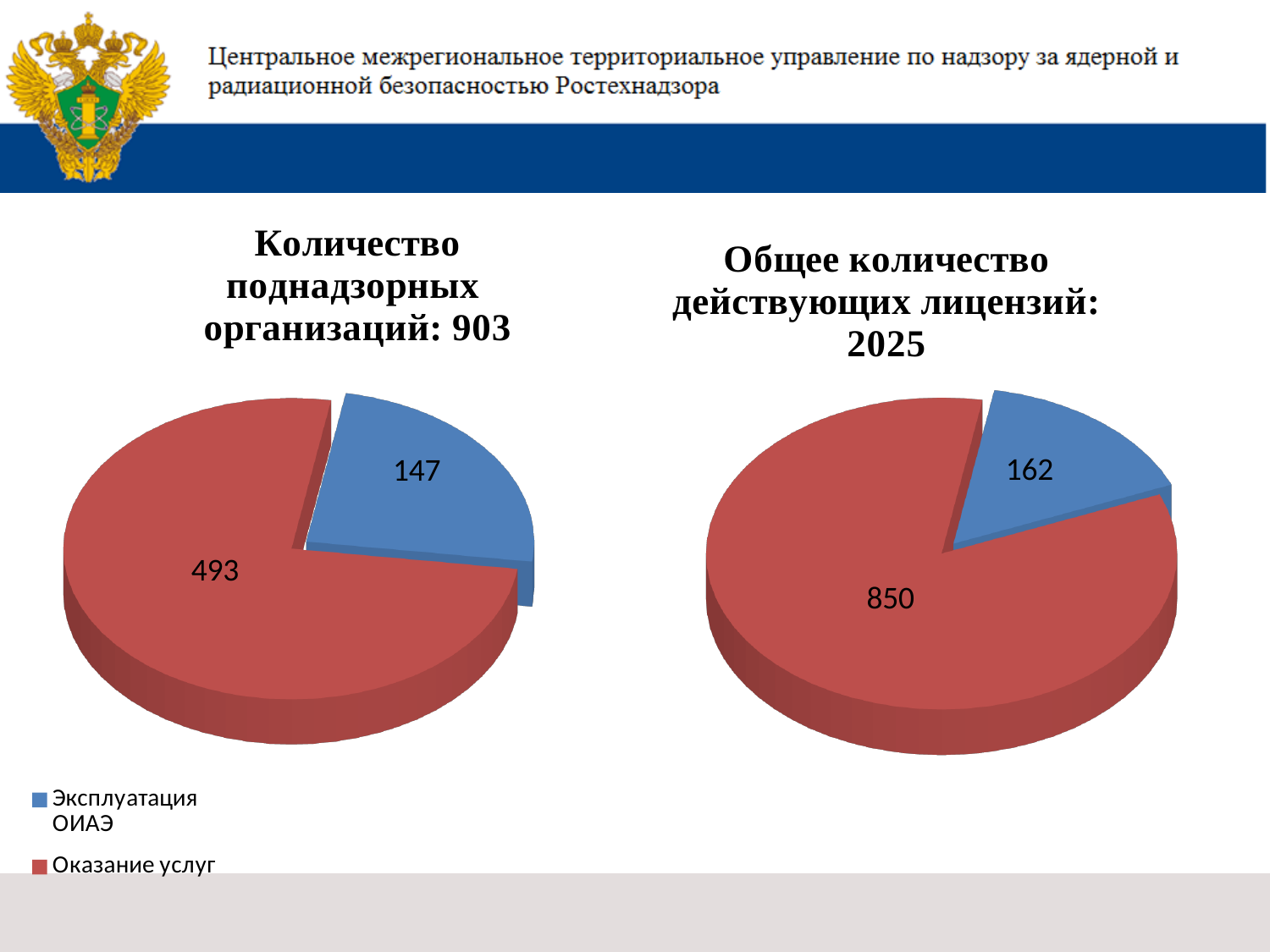
In the left pie chart (Количество поднадзорных организаций), what is the value for Эксплуатация ОИАЭ? 147 In the right pie chart (Общее количество действующих лицензий), what is the value for Эксплуатация ОИАЭ? 162 In the left pie chart (Количество поднадзорных организаций), what is the value for Оказание услуг? 493 Which is larger: the value for Эксплуатация ОИАЭ in the left pie chart or in the right pie chart? The right pie chart (162) In the left pie chart, which category has the largest slice? Оказание услуг What colour represents Оказание услуг in the pie charts? Red In the left pie chart, what is the difference between the values for Оказание услуг and Эксплуатация ОИАЭ? 346 In the right pie chart (Общее количество действующих лицензий), what is the value for Оказание услуг? 850 What type of chart is used on this slide? Pie chart In the right pie chart, which category has the smallest slice? Эксплуатация ОИАЭ How many categories does the legend list? 2 In the right pie chart, what is the difference between the values for Оказание услуг and Эксплуатация ОИАЭ? 688